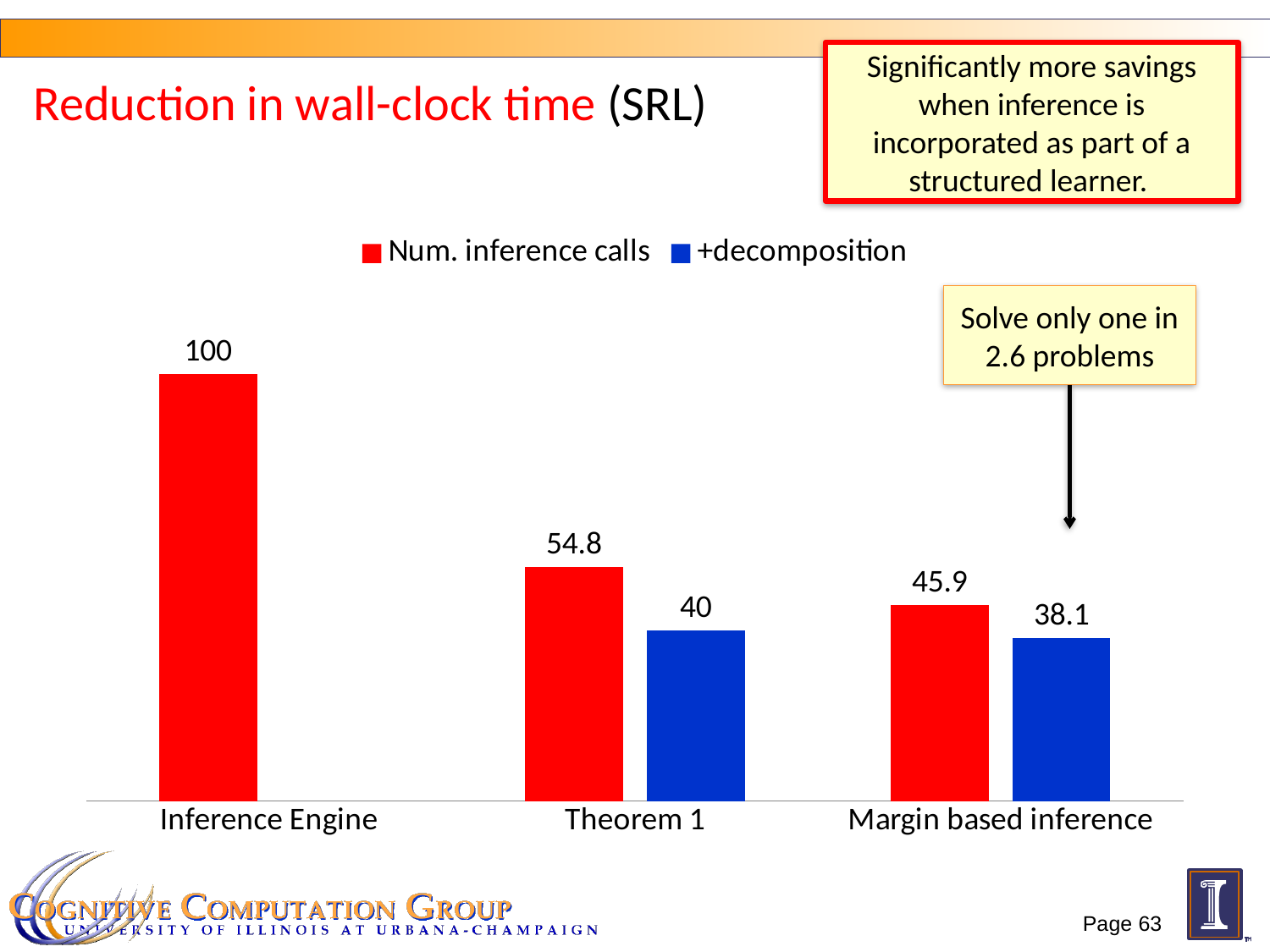
What is the value of Num. inference calls for Margin based inference? 45.9 Which is larger: the +decomposition value for Theorem 1 or the +decomposition value for Margin based inference? Theorem 1 What is the difference between the Num. inference calls value and the +decomposition value for Theorem 1? 14.8 What kind of chart is shown on the slide? Bar chart What is the value of Num. inference calls for Theorem 1? 54.8 How many series does the legend list? 2 What is the value of Num. inference calls for Inference Engine? 100 Which category has the highest Num. inference calls value? Inference Engine What is the difference between the Num. inference calls value and the +decomposition value for Margin based inference? 7.8 What is the value of +decomposition for Margin based inference? 38.1 Which category has the lowest Num. inference calls value? Margin based inference What is the value of +decomposition for Theorem 1? 40